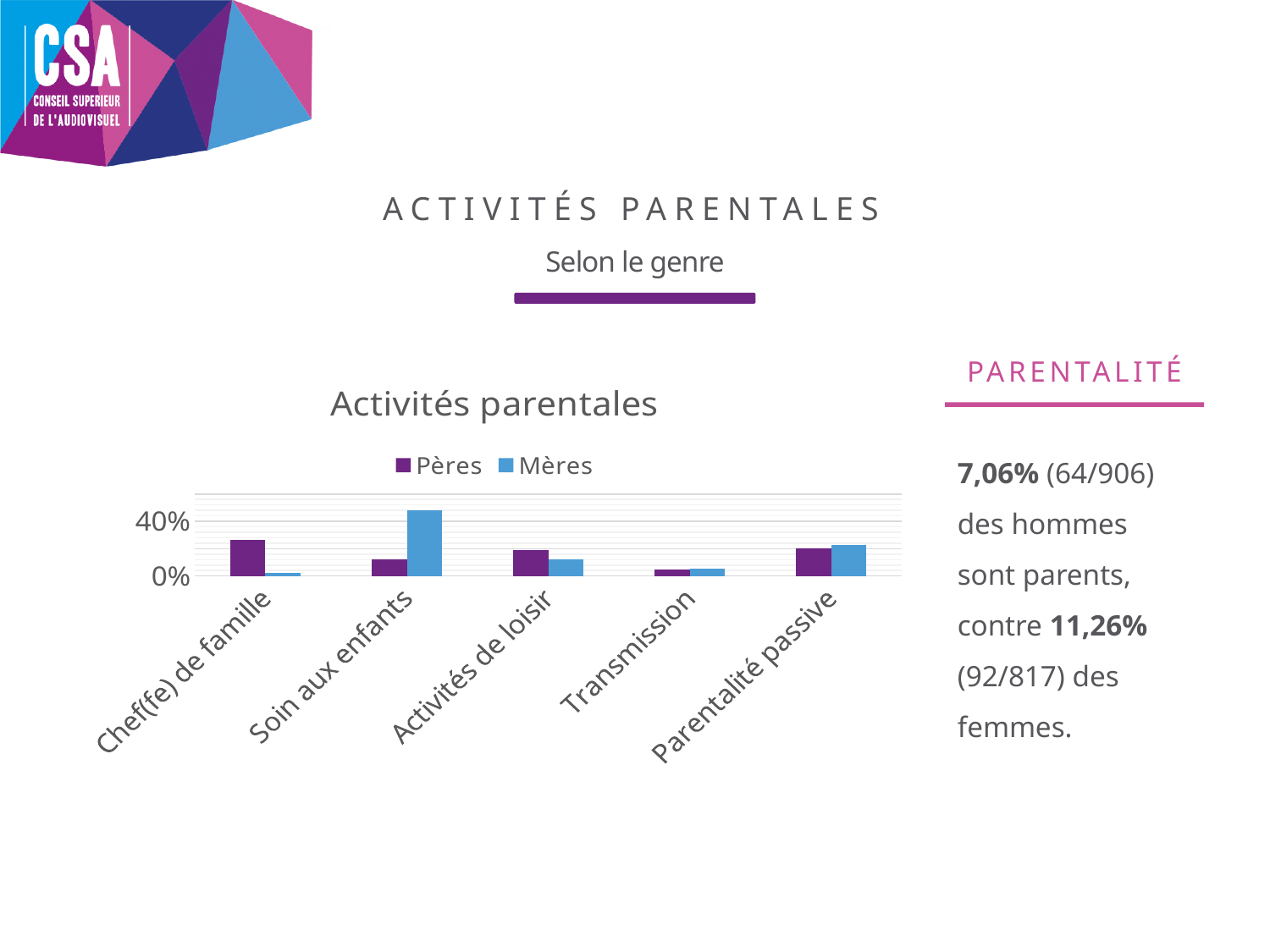
In the 'Activités parentales' chart, which category has the lowest value for Mères? Chef(fe) de famille In the 'Activités parentales' chart, which category has the lowest value for Pères? Transmission What kind of chart is 'Activités parentales'? bar chart In the 'Activités parentales' chart, for 'Chef(fe) de famille', which series is larger: Pères or Mères? Pères In the 'Activités parentales' chart, for 'Soin aux enfants', which series is larger: Pères or Mères? Mères How many series does the legend of the 'Activités parentales' chart list? 2 In the 'Activités parentales' chart, which category has the highest value for Mères? Soin aux enfants In the 'Activités parentales' chart, which category has the highest value for Pères? Chef(fe) de famille In the 'Activités parentales' chart, is the value for Pères in 'Chef(fe) de famille' greater or less than 40%? less In the 'Activités parentales' chart, is the value for Mères in 'Soin aux enfants' greater or less than 40%? greater In the 'Activités parentales' chart, which colour represents the Mères series? blue How many categories are shown on the x axis of the 'Activités parentales' chart? 5